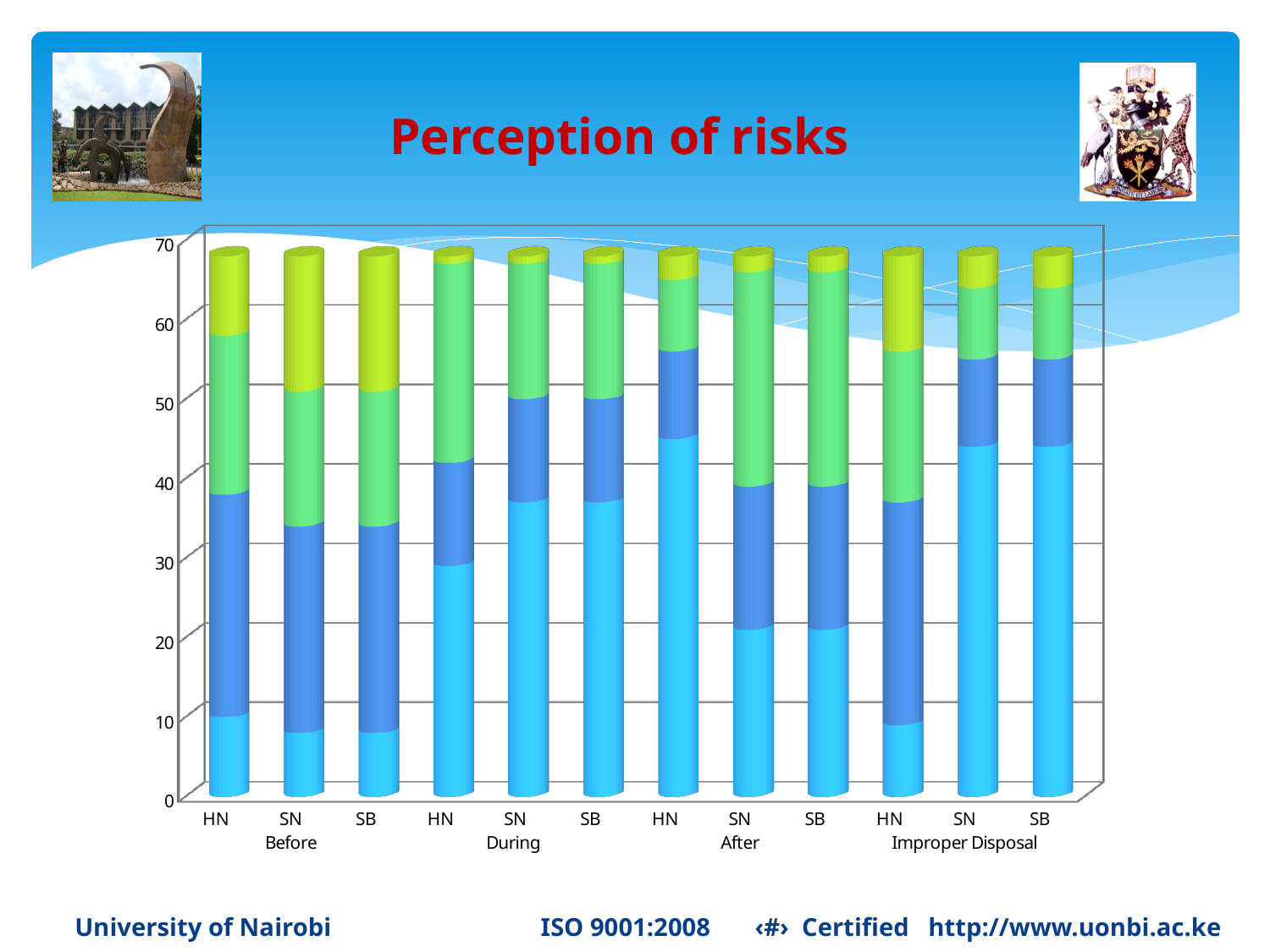
Which has the larger bottom (light blue) segment: the HN bar in the Before group or the HN bar in the During group? HN in the During group What kind of chart is shown on the slide? Stacked bar chart How many category groups are shown along the x axis? 4 Is the bottom (light blue) segment of the HN bar in the During group greater or less than 20? greater Is the bottom (light blue) segment of the HN bar in the After group greater or less than 40? greater How many bars are plotted in the chart? 12 What is the highest value shown on the y axis? 70 Is the bottom (light blue) segment of the SN bar in the After group greater or less than 30? less What are the four group labels along the x axis? Before, During, After, Improper Disposal Which has the larger bottom (light blue) segment: the SN bar in the During group or the SN bar in the After group? SN in the During group What is the title of the chart? Perception of risks